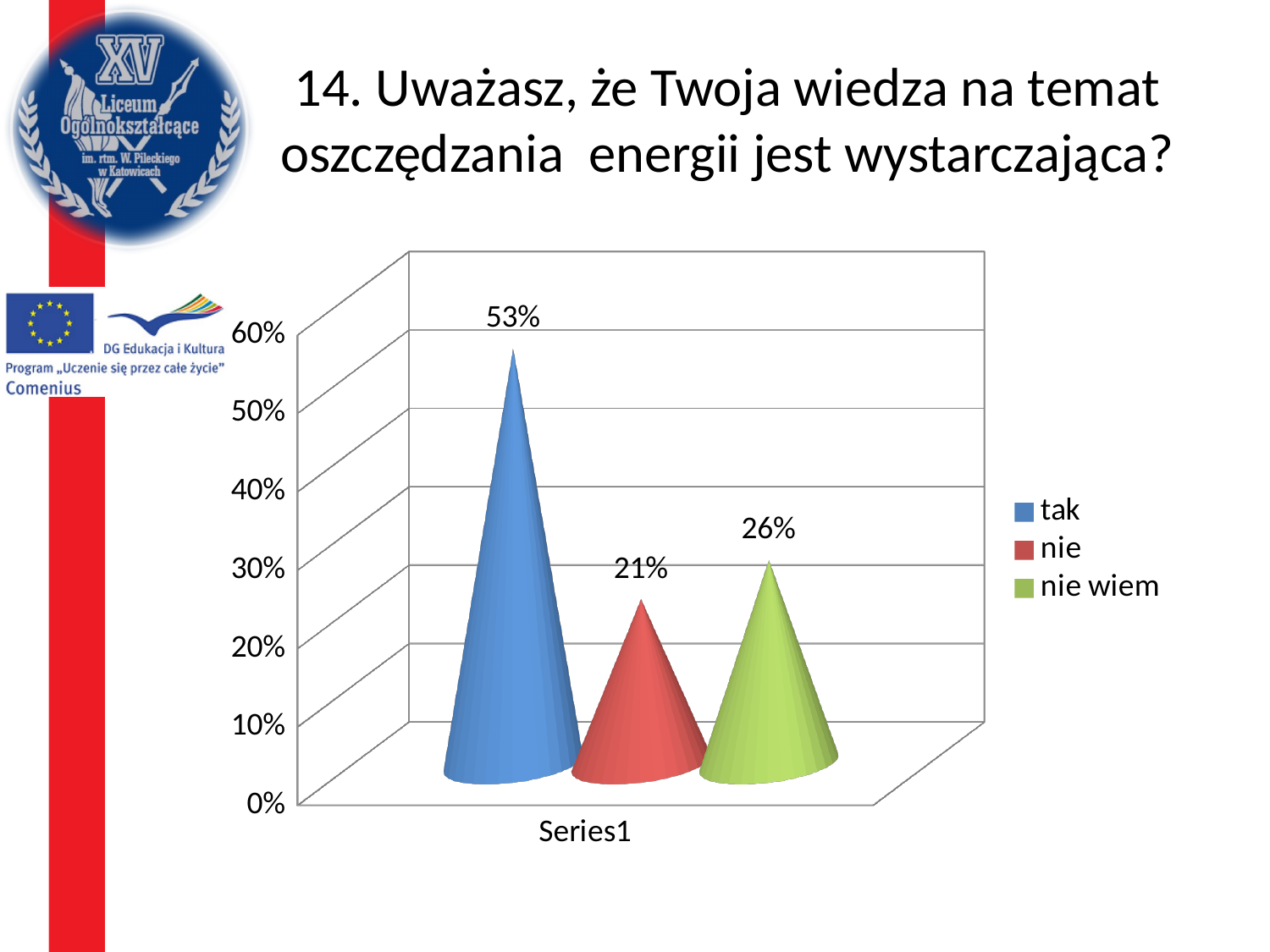
Is the value for "tak" greater or less than 50%? greater What colour is the bar for "nie wiem"? green What is the difference between the values for "nie wiem" and "nie"? 5% Which is larger, the value for "nie" or the value for "nie wiem"? nie wiem What is the difference between the values for "tak" and "nie"? 32% How many entries does the legend list? 3 What kind of chart is shown on the slide? bar chart Which answer has the highest value? tak Which answer has the lowest value? nie What is the value for "nie wiem"? 26% What is the value for "nie"? 21% What is the value for "tak"? 53%